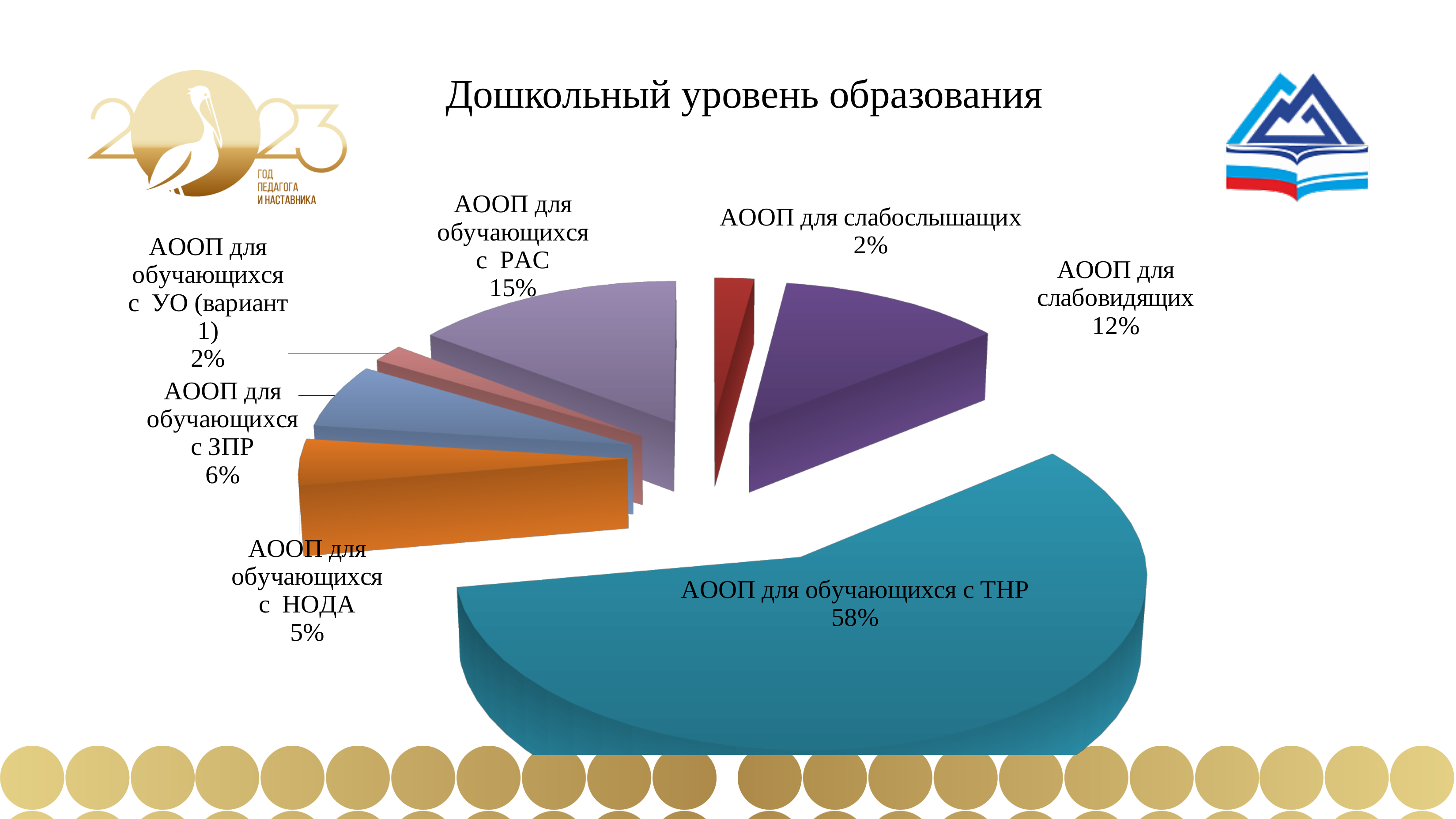
What share of the pie is АООП для обучающихся с РАС? 15% What share of the pie is АООП для обучающихся с ТНР? 58% What kind of chart is shown on the slide? pie chart What share of the pie is АООП для слабовидящих? 12% What share of the pie is АООП для обучающихся с НОДА? 5% How many slices does the pie chart have? 7 What share of the pie is АООП для слабослышащих? 2% What share of the pie is АООП для обучающихся с ЗПР? 6% What is the difference between the shares for АООП для обучающихся с РАС and АООП для слабовидящих? 3% Which category has the largest share of the pie? АООП для обучающихся с ТНР Which is larger: the share for АООП для обучающихся с ЗПР or АООП для обучающихся с НОДА? АООП для обучающихся с ЗПР What is the title of the chart? Дошкольный уровень образования